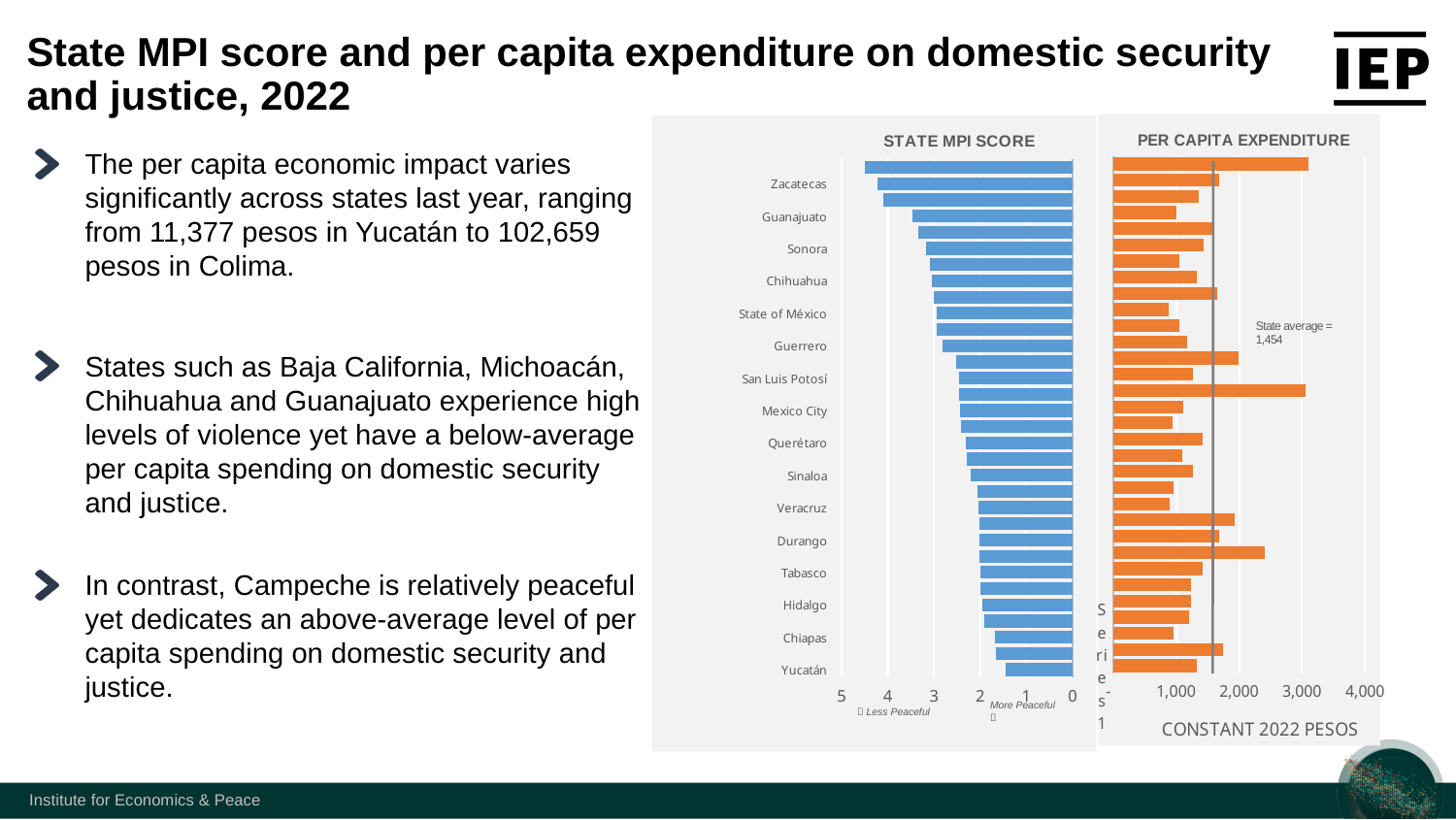
In the STATE MPI SCORE chart, which has the larger value, Zacatecas or Yucatán? Zacatecas In the STATE MPI SCORE chart, is the value for Hidalgo greater or less than 3? less In the STATE MPI SCORE chart, which of the labelled states has the lowest value? Yucatán In the STATE MPI SCORE chart, do the bar values rise or fall going from the top of the chart to the bottom? fall In the PER CAPITA EXPENDITURE chart, is the value for Durango greater or less than 2,000? less What kind of chart is the STATE MPI SCORE chart? bar chart In the STATE MPI SCORE chart, is the value for Chihuahua greater or less than 2? greater In the PER CAPITA EXPENDITURE chart, what is the state average shown by the annotation? 1,454 What is the x-axis label of the PER CAPITA EXPENDITURE chart? CONSTANT 2022 PESOS